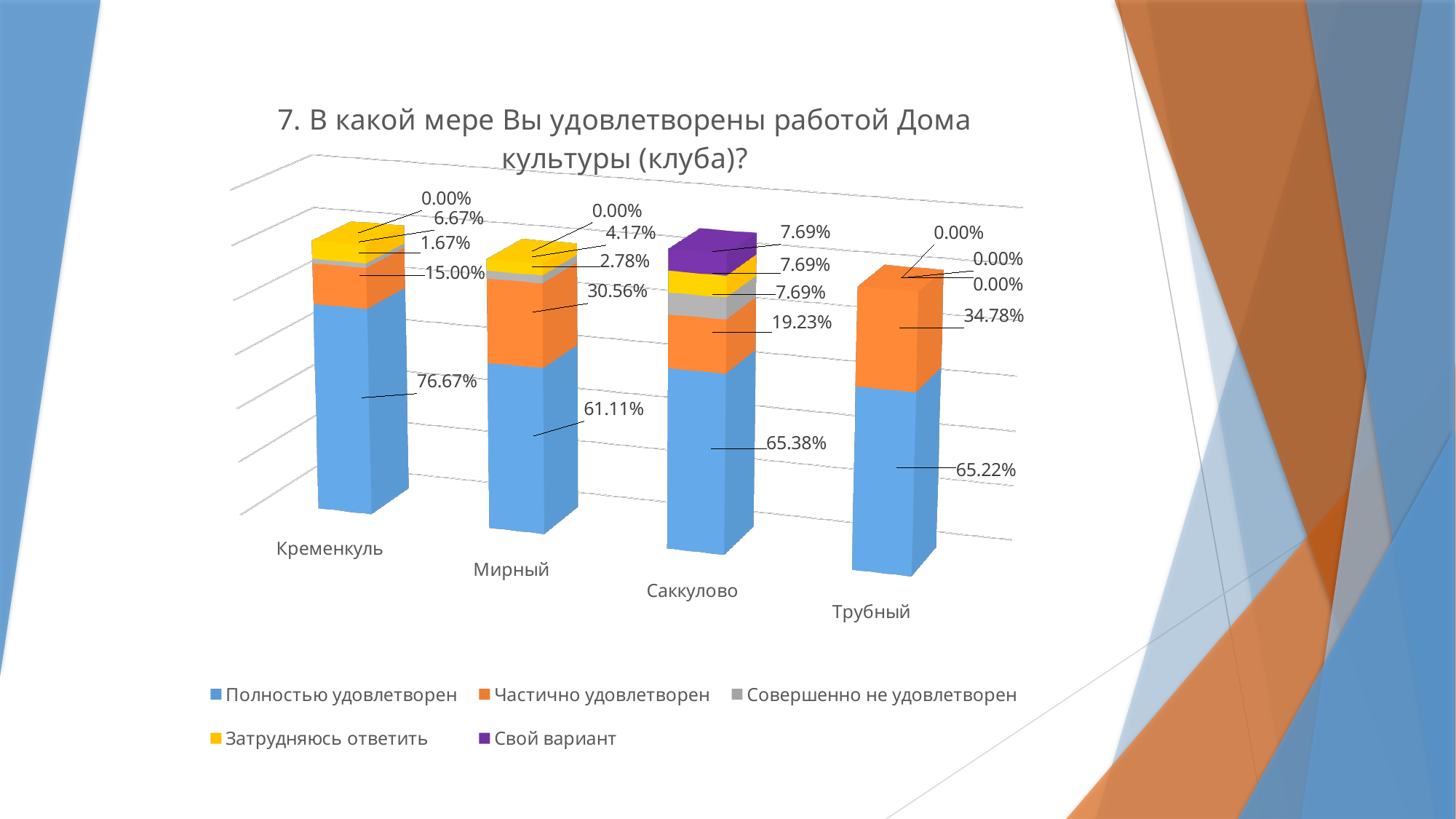
What kind of chart is shown on the slide? Stacked bar chart What is the value for "Затрудняюсь ответить" in Мирный? 4.17% Which category has the lowest value for "Полностью удовлетворен"? Мирный How many categories are shown on the x axis? 4 Which is larger: the "Частично удовлетворен" value for Мирный or for Саккулово? Мирный What is the difference between the "Полностью удовлетворен" values for Кременкуль and Мирный? 15.56% Which category has the highest value for "Полностью удовлетворен"? Кременкуль What is the value for "Свой вариант" in Саккулово? 7.69% What is the value for "Частично удовлетворен" in Трубный? 34.78% How many series does the legend list? 5 Which category has the highest value for "Частично удовлетворен"? Трубный What is the value for "Полностью удовлетворен" in Кременкуль? 76.67%